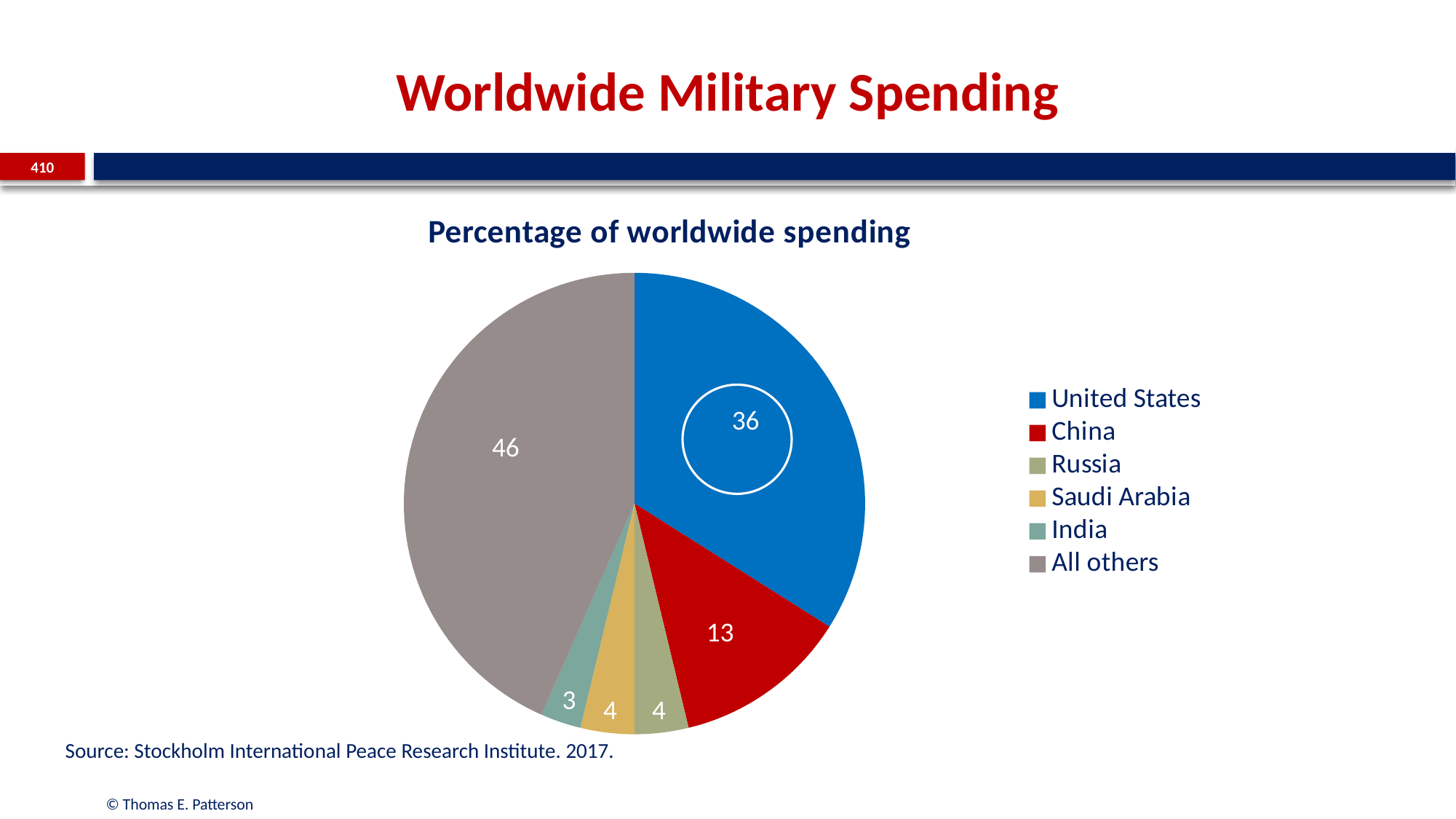
What is the value shown for India? 3 What is the title of the chart? Percentage of worldwide spending What is the value shown for All others? 46 What kind of chart is shown on the slide? pie chart What is the difference between the values for the United States and China? 23 Which category has the smallest slice of the pie? India What is the value shown for the United States? 36 How many categories does the legend list? 6 Which category has the largest slice of the pie? All others What is the value shown for Saudi Arabia? 4 Which is larger, the value for China or the value for Russia? China What is the value shown for China? 13